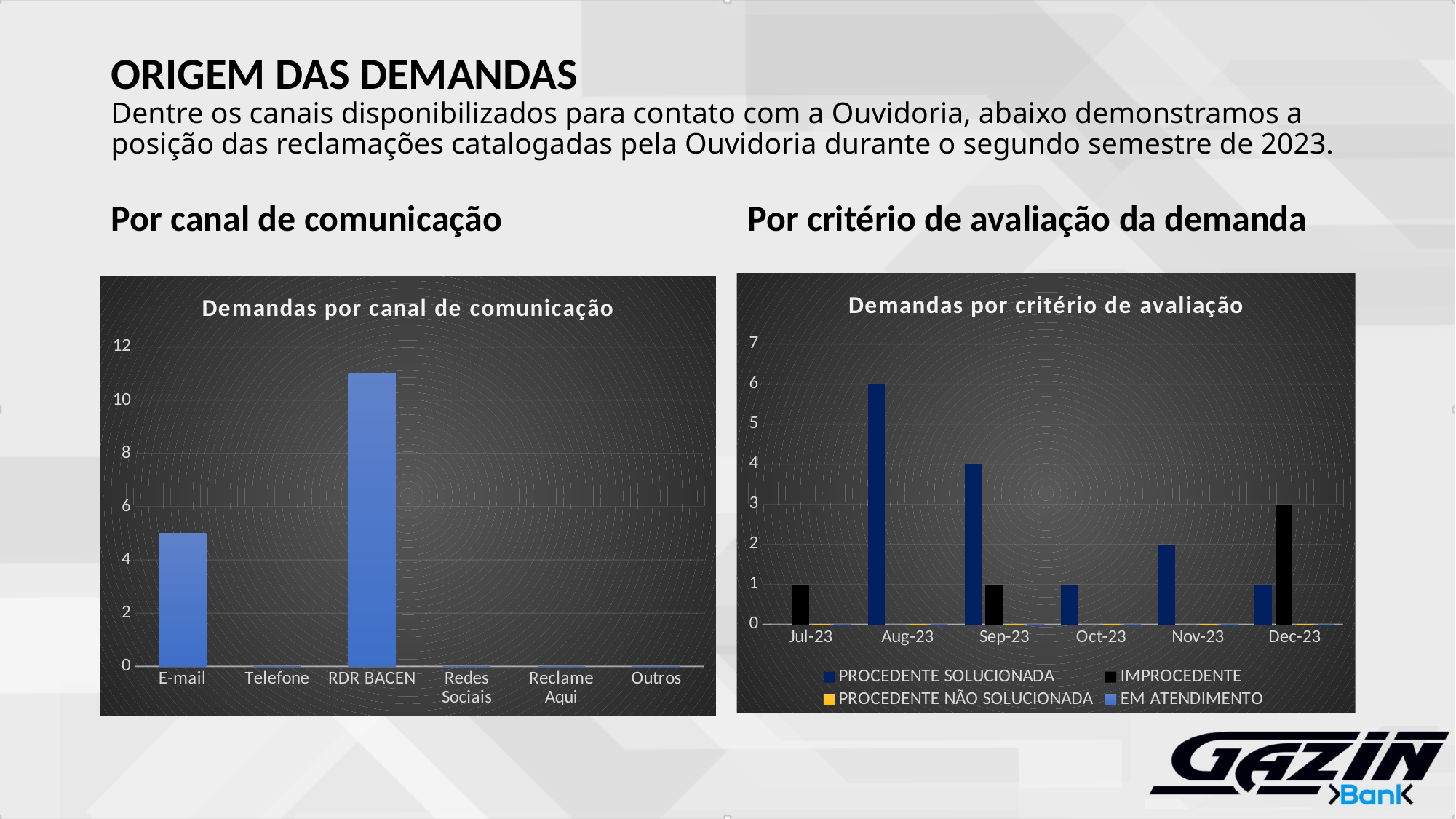
In the chart 'Demandas por canal de comunicação', is the value for RDR BACEN greater or less than 10? greater How many series does the legend of the chart 'Demandas por critério de avaliação' list? 4 In the chart 'Demandas por critério de avaliação', what is the value of IMPROCEDENTE for Dec-23? 3 In the chart 'Demandas por canal de comunicação', which channel has the highest value? RDR BACEN In the chart 'Demandas por critério de avaliação', which month has the highest PROCEDENTE SOLUCIONADA value? Aug-23 What type of chart is 'Demandas por canal de comunicação'? bar chart In the chart 'Demandas por critério de avaliação', which is larger for Dec-23: PROCEDENTE SOLUCIONADA or IMPROCEDENTE? IMPROCEDENTE In the chart 'Demandas por critério de avaliação', what is the value of PROCEDENTE SOLUCIONADA for Sep-23? 4 In the chart 'Demandas por critério de avaliação', what is the difference between PROCEDENTE SOLUCIONADA in Aug-23 and in Nov-23? 4 How many categories are shown on the x axis of the chart 'Demandas por canal de comunicação'? 6 In the chart 'Demandas por critério de avaliação', what is the value of PROCEDENTE SOLUCIONADA for Aug-23? 6 In the chart 'Demandas por canal de comunicação', is the value for E-mail greater or less than 6? less